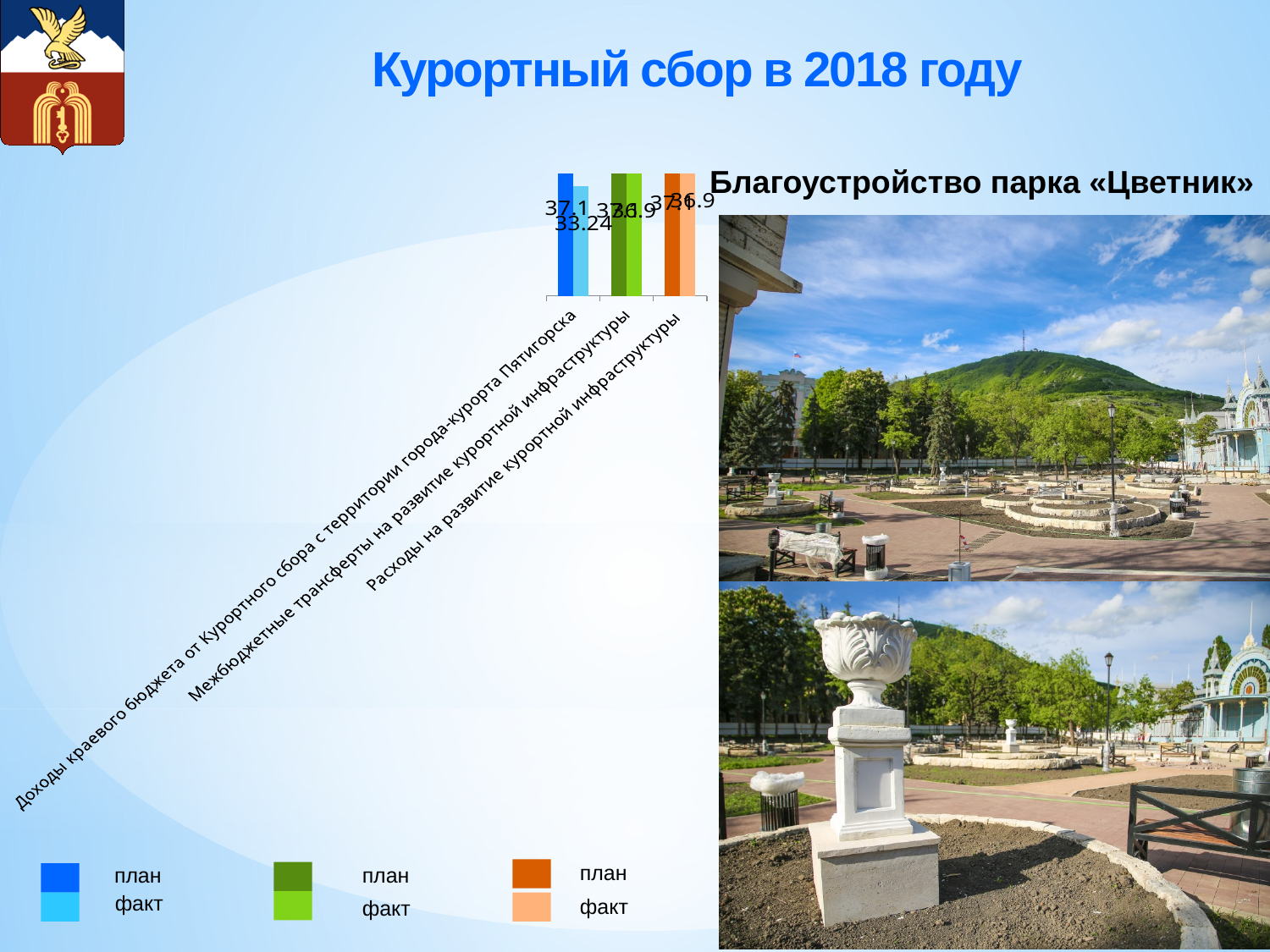
What is the plan (план) value for «Доходы краевого бюджета от Курортного сбора с территории города-курорта Пятигорска»? 37.1 What is the difference between the plan and fact values for «Доходы краевого бюджета от Курортного сбора с территории города-курорта Пятигорска»? 3.86 What two legend labels are shown for each colour pair under the chart? план and факт How many categories are shown on the x axis of the chart? 3 What is the title of the slide containing the chart? Курортный сбор в 2018 году What kind of chart is shown on the slide? bar chart Which category has the lowest fact (факт) value in the chart? Доходы краевого бюджета от Курортного сбора с территории города-курорта Пятигорска For «Доходы краевого бюджета от Курортного сбора с территории города-курорта Пятигорска», which is larger: the plan or the fact value? план What is the fact (факт) value for «Доходы краевого бюджета от Курортного сбора с территории города-курорта Пятигорска»? 33.24